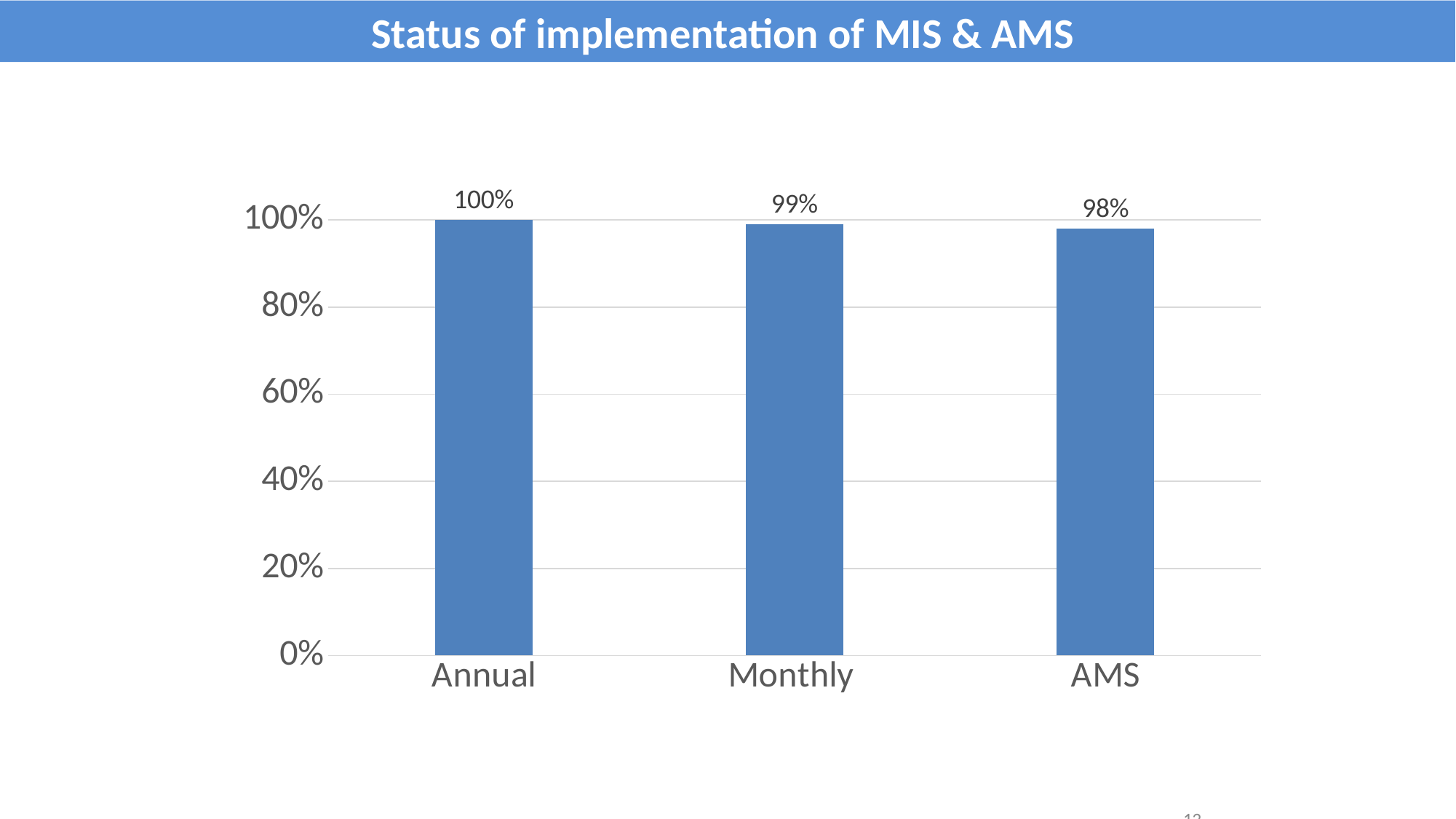
Which category has the highest value? Annual What is the difference between the values for Monthly and AMS? 1% What is the title of the slide? Status of implementation of MIS & AMS Which is larger, the value for Monthly or the value for AMS? Monthly What is the value for AMS? 98% What kind of chart is shown on the slide? bar chart What is the value for Monthly? 99% How many categories are shown on the x axis? 3 Is the value for AMS greater or less than 80%? greater What is the difference between the values for Annual and AMS? 2% What is the value for Annual? 100% Which category has the lowest value? AMS